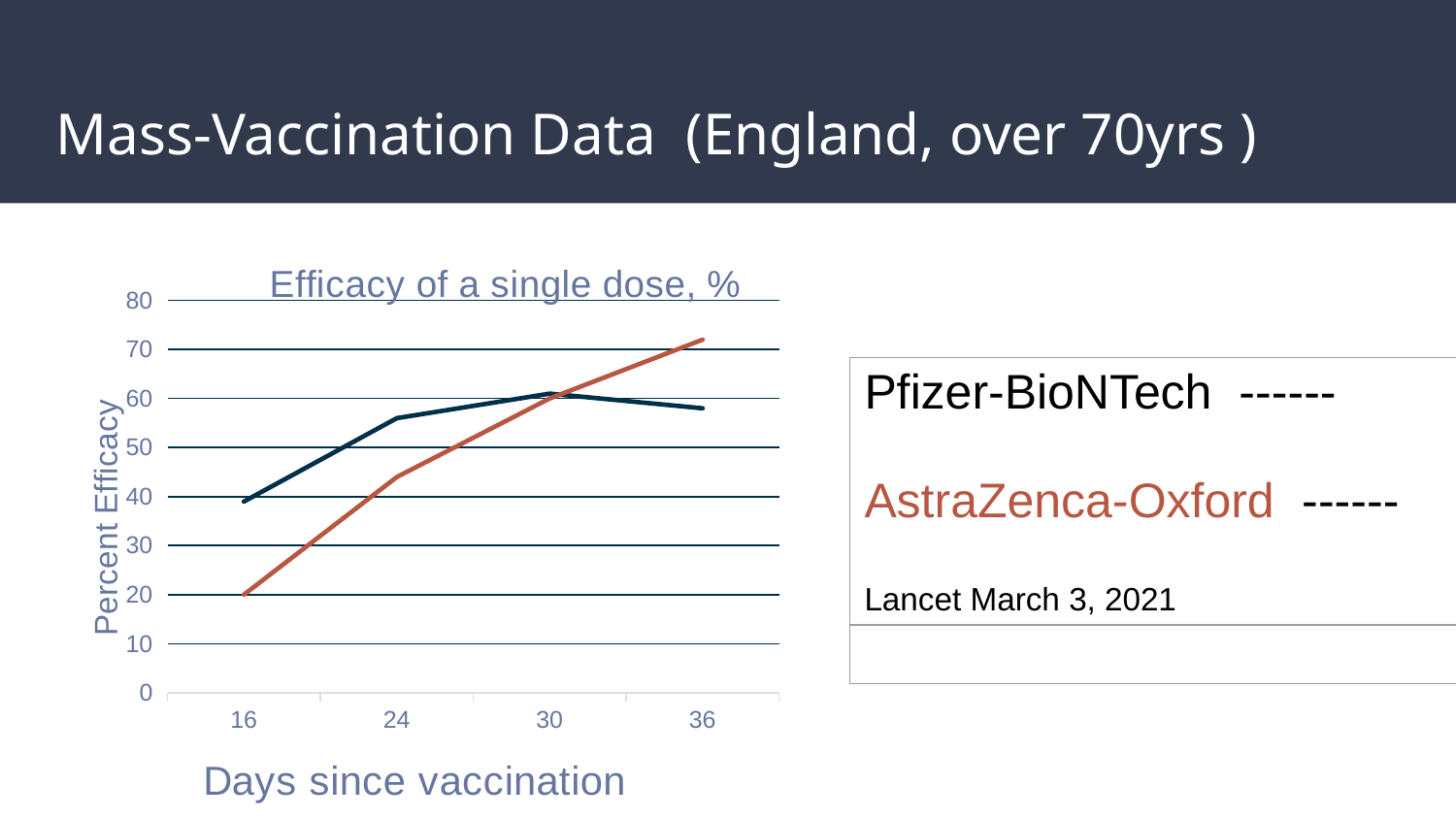
At 16 days since vaccination, which vaccine has the higher efficacy, Pfizer-BioNTech or AstraZenca-Oxford? Pfizer-BioNTech Is the AstraZenca-Oxford value at 36 days greater or less than 60? greater Is the AstraZenca-Oxford value at 16 days greater or less than 30? less What kind of chart is shown on the slide? Line chart What is the title of the chart? Efficacy of a single dose, % At 36 days since vaccination, which vaccine has the higher efficacy, Pfizer-BioNTech or AstraZenca-Oxford? AstraZenca-Oxford Is the Pfizer-BioNTech value at 16 days greater or less than 30? greater Does the AstraZenca-Oxford line rise or fall from 16 to 36 days since vaccination? Rises How many lines (series) are plotted on the chart? 2 What is the label of the x axis of the chart? Days since vaccination How many points on the x axis (days since vaccination) are shown on the chart? 4